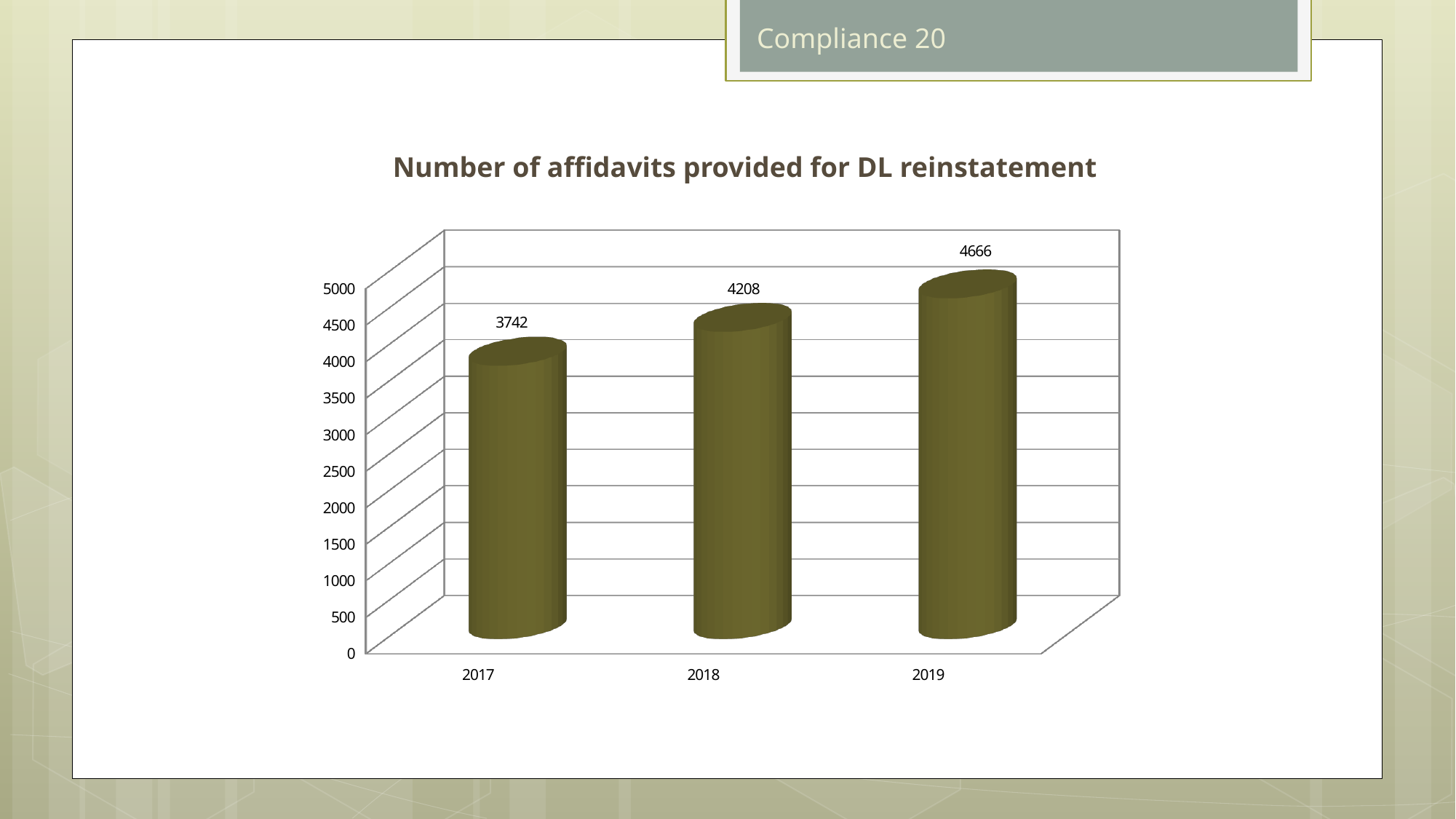
Which year has the lowest number of affidavits provided for DL reinstatement? 2017 What is the difference between the number of affidavits in 2019 and in 2017? 924 Which year has more affidavits provided for DL reinstatement, 2018 or 2019? 2019 What kind of chart is shown on the slide? Bar chart Which year has the highest number of affidavits provided for DL reinstatement? 2019 Do the values rise or fall from 2017 to 2019? Rise Is the value for 2017 greater or less than 4000? less How many years are shown on the chart? 3 What is the number of affidavits provided for DL reinstatement in 2018? 4208 What is the number of affidavits provided for DL reinstatement in 2017? 3742 What is the difference between the number of affidavits in 2018 and in 2017? 466 What is the number of affidavits provided for DL reinstatement in 2019? 4666